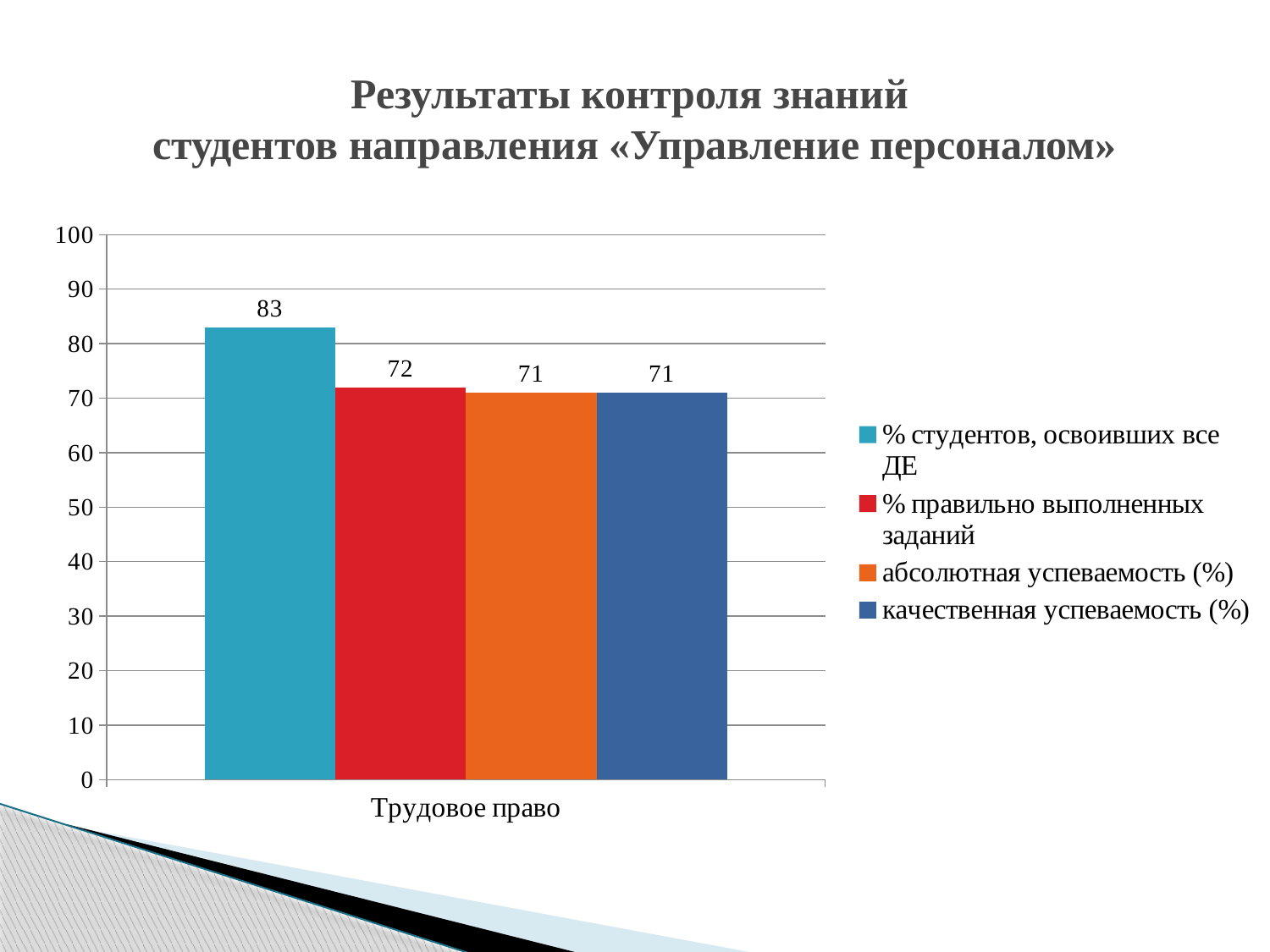
What is the value for "абсолютная успеваемость (%)" for Трудовое право? 71 What is the difference between "% правильно выполненных заданий" and "абсолютная успеваемость (%)" for Трудовое право? 1 Which is larger for Трудовое право: "% студентов, освоивших все ДЕ" or "качественная успеваемость (%)"? % студентов, освоивших все ДЕ What is the value for "качественная успеваемость (%)" for Трудовое право? 71 What is the difference between "% студентов, освоивших все ДЕ" and "% правильно выполненных заданий" for Трудовое право? 11 What category is shown on the x axis of the chart? Трудовое право Is the value for "% студентов, освоивших все ДЕ" greater or less than 80? greater Which series has the highest value for Трудовое право? % студентов, освоивших все ДЕ What is the value for "% студентов, освоивших все ДЕ" for Трудовое право? 83 What is the value for "% правильно выполненных заданий" for Трудовое право? 72 What kind of chart is shown on the slide? bar chart How many series does the legend list? 4